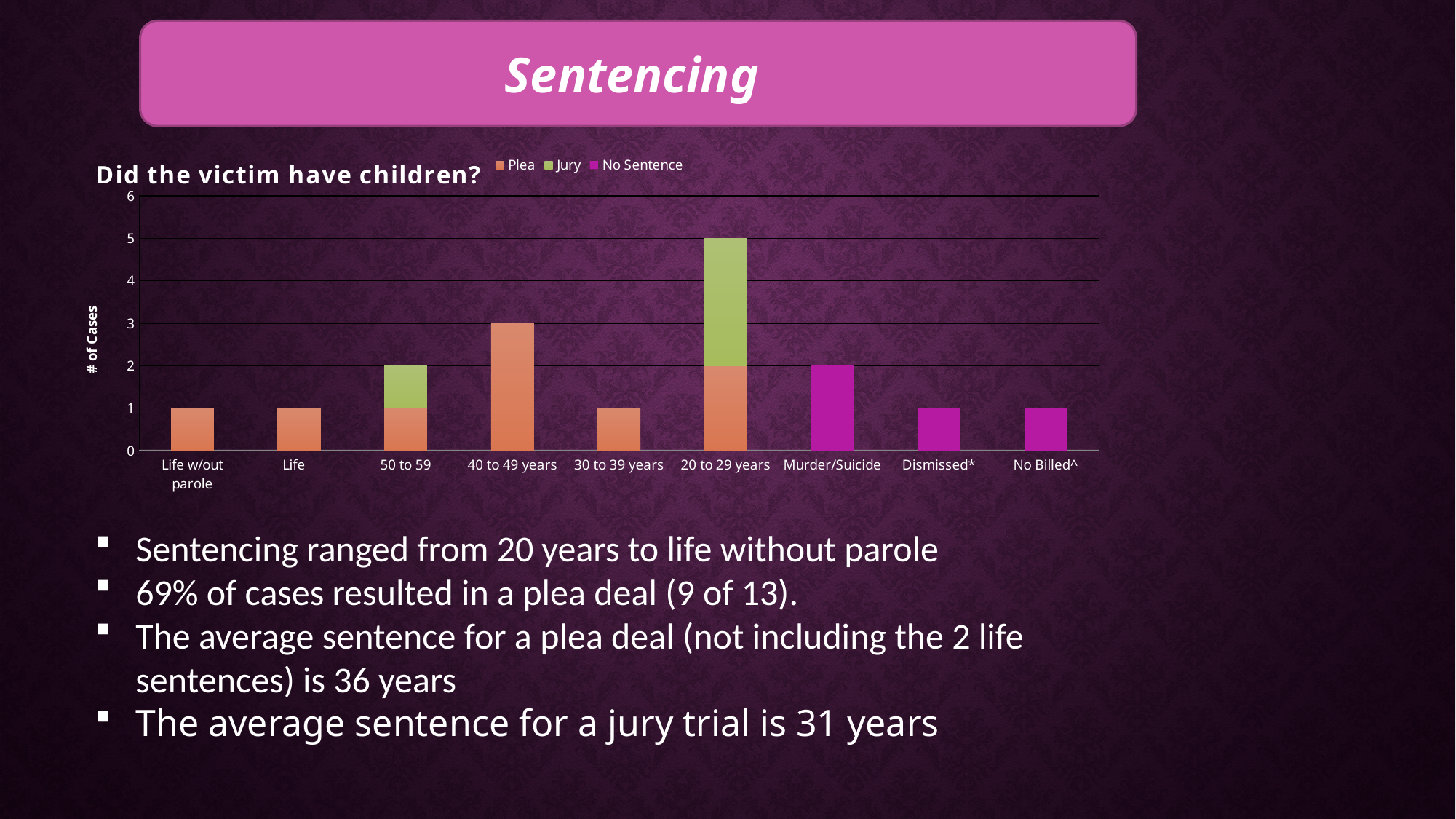
How many series does the chart legend list? 3 What is the Plea value for 40 to 49 years? 3 Which is larger, the stacked bar for 20 to 29 years or the bar for Murder/Suicide? 20 to 29 years Which series is shown in green in the chart legend? Jury Which category has the tallest stacked bar in the chart? 20 to 29 years What is the label on the y axis of the chart? # of Cases What is the No Sentence value for Murder/Suicide? 2 What is the total height of the stacked bar for 50 to 59? 2 How many categories are shown on the x axis of the chart? 9 What is the total height of the stacked bar for 20 to 29 years? 5 What is the difference between the Plea value for 40 to 49 years and the Plea value for 30 to 39 years? 2 What kind of chart is shown on the slide? bar chart